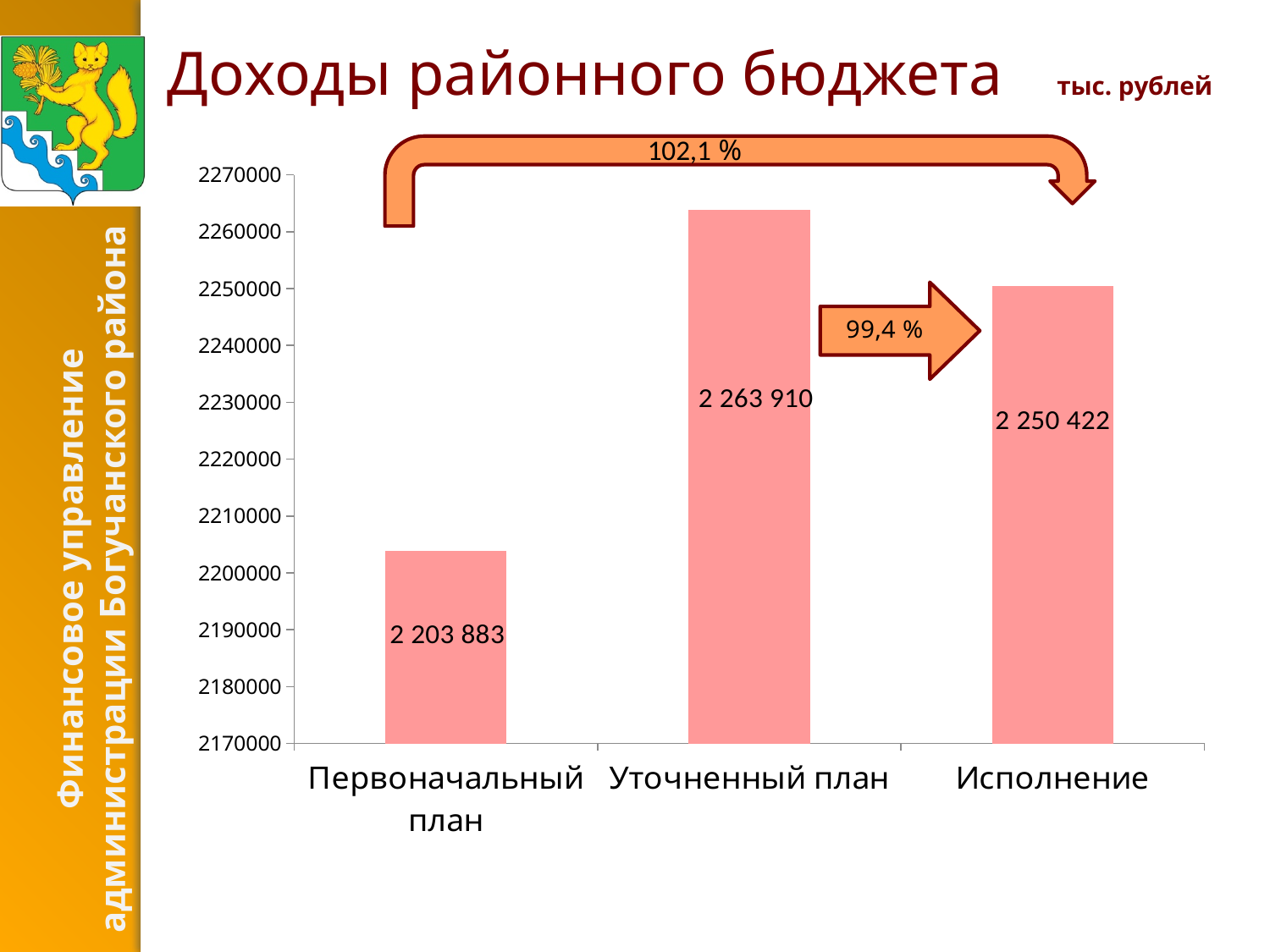
What is the value for Исполнение? 2 250 422 What kind of chart is shown on the slide? bar chart What is the value for Уточненный план? 2 263 910 Which category has the lowest value? Первоначальный план Which is larger, Исполнение or Первоначальный план? Исполнение Is the value for Исполнение greater or less than 2240000? greater What is the value for Первоначальный план? 2 203 883 Which category has the highest value? Уточненный план How many categories are shown on the chart? 3 What is the difference between Уточненный план and Исполнение? 13 488 What percentage is shown on the arrow from Уточненный план to Исполнение? 99,4 % What is the difference between Уточненный план and Первоначальный план? 60 027